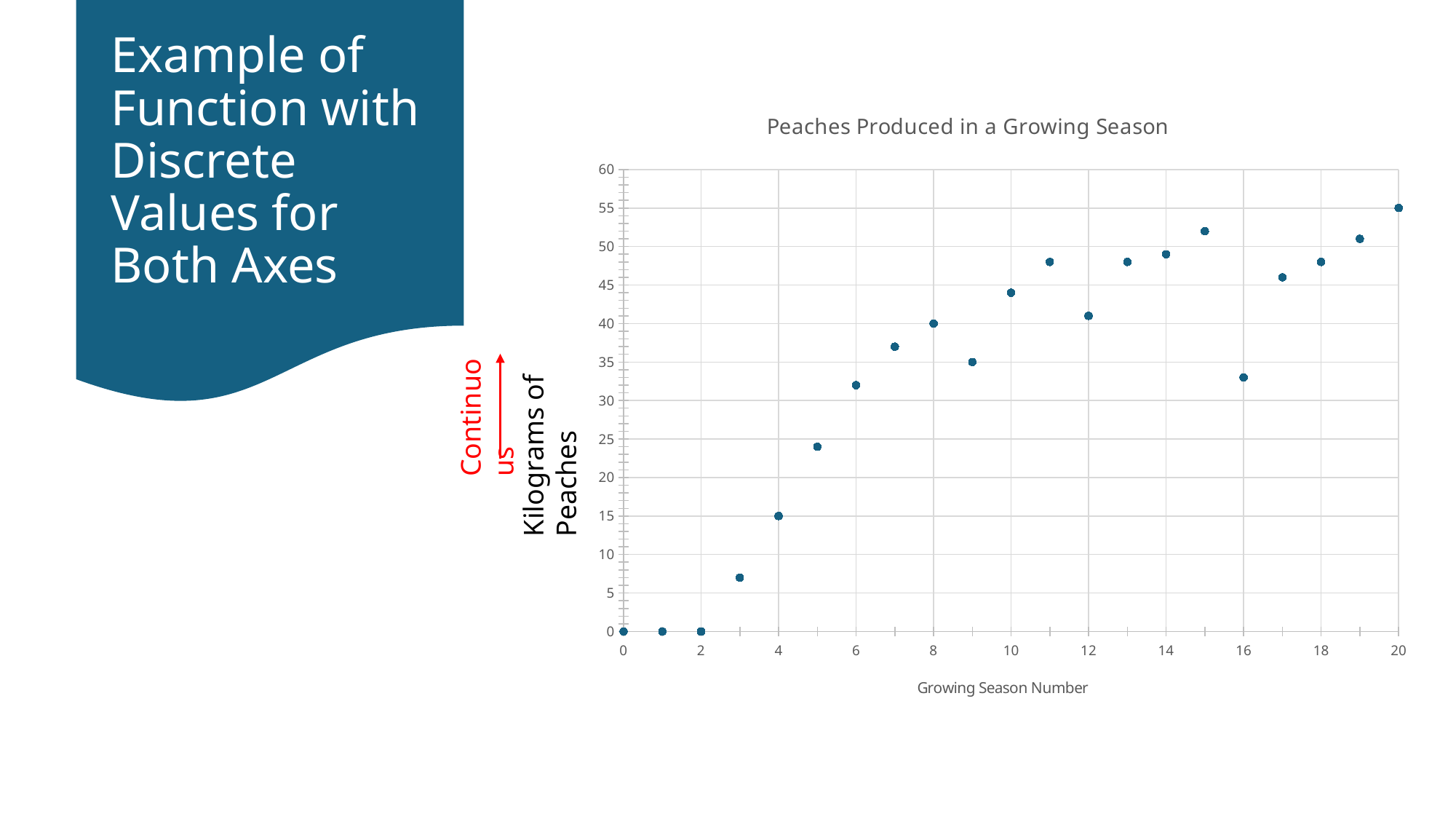
Which growing season number has the highest kilograms of peaches? 20 How many kilograms of peaches were produced in growing season 4? 15 What is the title of the chart? Peaches Produced in a Growing Season How many kilograms of peaches were produced in growing season 1? 0 How many data points are plotted on the chart? 21 Which has more kilograms of peaches, growing season 9 or growing season 10? Growing season 10 How many kilograms of peaches were produced in growing season 8? 40 What is the label of the x axis? Growing Season Number How many kilograms of peaches were produced in growing season 20? 55 What kind of chart is shown on the slide? Scatter chart Is the value for growing season 15 greater or less than 50? greater Is the value for growing season 16 greater or less than 40? less